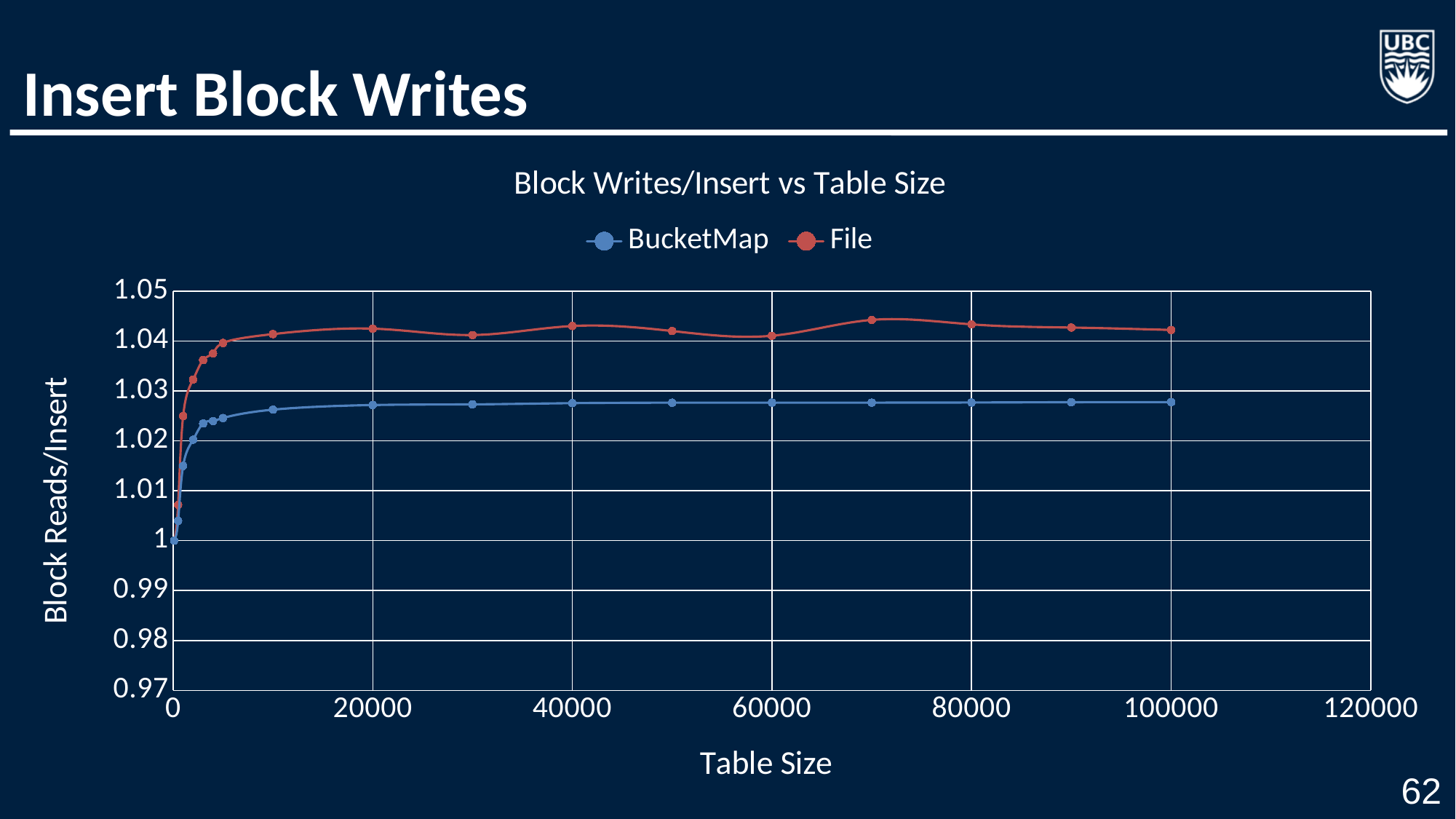
Does the BucketMap series rise or fall as table size increases from 0 to 10000? rise What kind of chart is shown on the slide? line chart Is the value for BucketMap at a table size of 100000 greater or less than 1.03? less Which series is lower across the whole range of table sizes? BucketMap Which series has the higher value at a table size of 20000, BucketMap or File? File Is the value for BucketMap at a table size of 60000 greater or less than 1.02? greater Is the value for File at a table size of 60000 greater or less than 1.03? greater Which series has the higher value at a table size of 100000, BucketMap or File? File What is the title of the chart? Block Writes/Insert vs Table Size What is the label on the y axis of the chart? Block Reads/Insert How many series does the legend list? 2